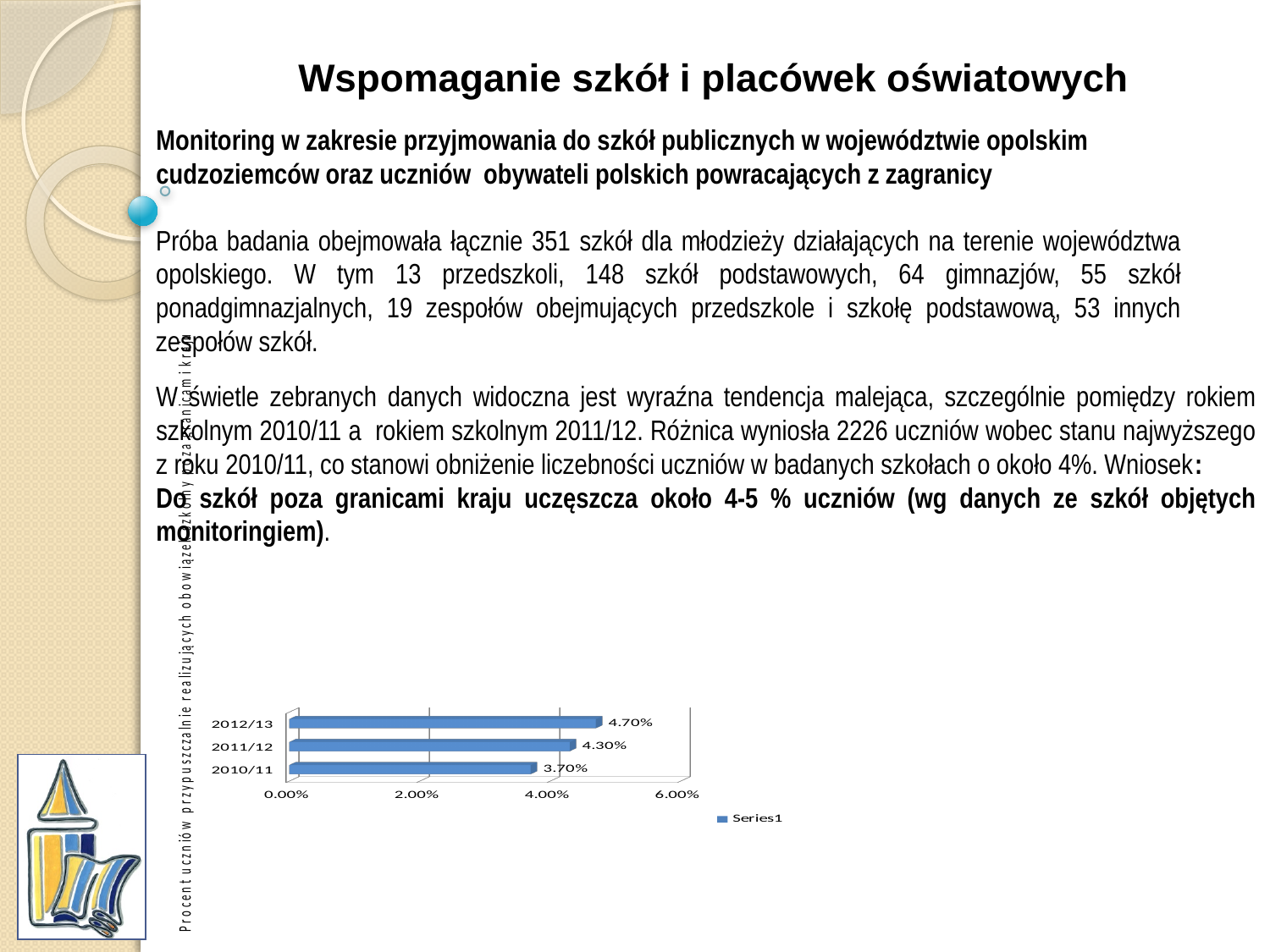
What is the difference between the values for 2012/13 and 2010/11? 1.00% Is the value for 2012/13 greater or less than 4.00%? greater What is the value for 2011/12? 4.30% What is the value for 2010/11? 3.70% What kind of chart is shown on the slide? bar chart How many series does the legend list? 1 Which school year has the lowest value? 2010/11 What is the value for 2012/13? 4.70% How many school years are shown in the chart? 3 What is the difference between the values for 2011/12 and 2010/11? 0.60% Which school year has the highest value? 2012/13 Which is larger, the value for 2011/12 or the value for 2010/11? 2011/12